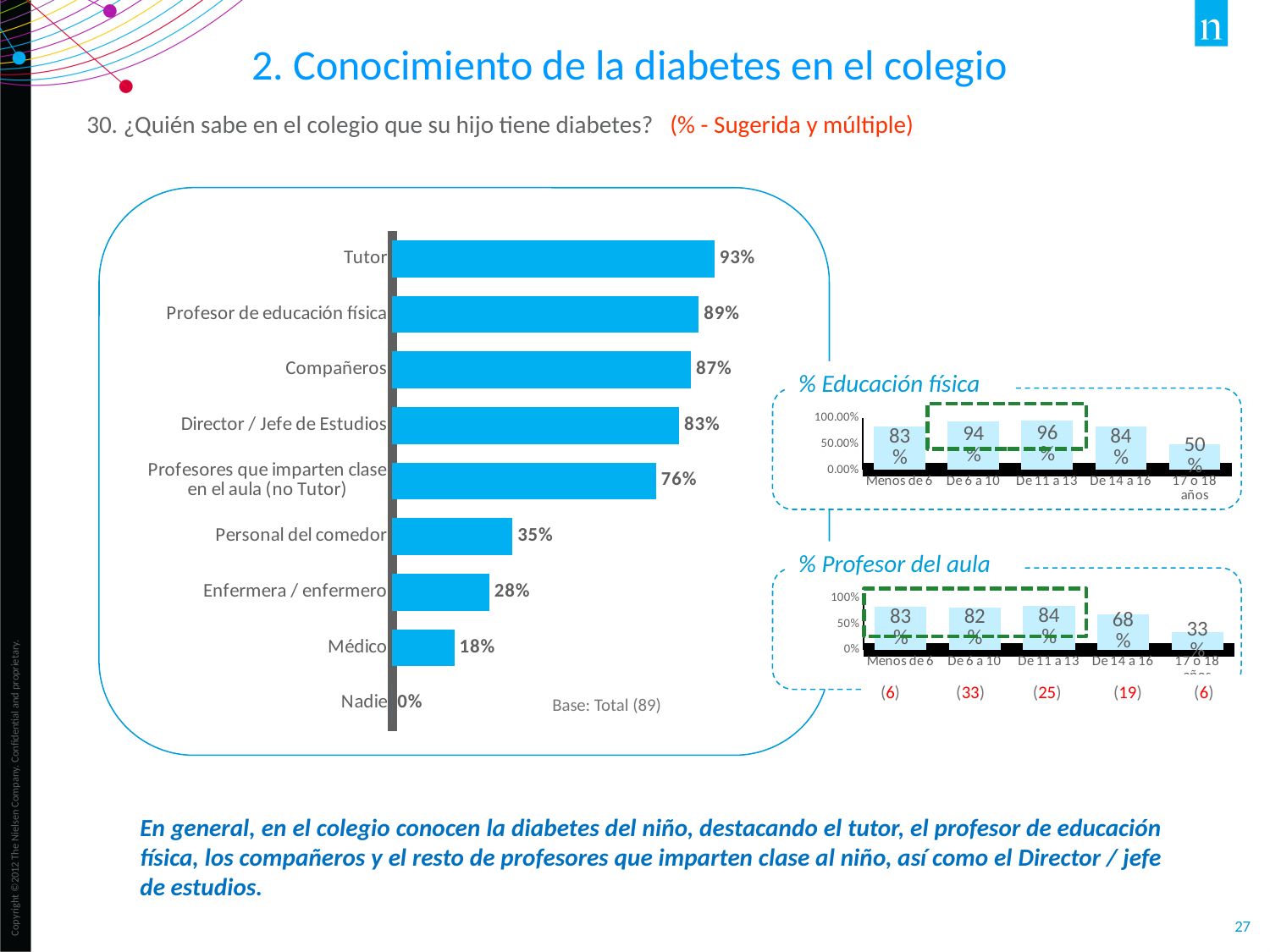
In the main bar chart on the left, what is the difference between the values for Tutor and Médico? 75% In the main bar chart on the left, which category has the lowest value? Nadie How many categories does the main bar chart on the left show? 9 What type of chart is the main chart on the left? Bar chart What base size is stated for the main bar chart on the left? Total (89) In the main bar chart on the left, what percentage is shown for Tutor? 93% In the '% Profesor del aula' chart, what is the difference between the values for De 11 a 13 and 17 o 18 años? 51% In the main bar chart on the left, what percentage is shown for Personal del comedor? 35% In the '% Profesor del aula' chart, what value is shown for De 14 a 16? 68% In the main bar chart on the left, which is larger: Enfermera / enfermero or Médico? Enfermera / enfermero In the '% Educación física' chart, what value is shown for De 11 a 13? 96% In the '% Educación física' chart, which age group has the lowest value? 17 o 18 años